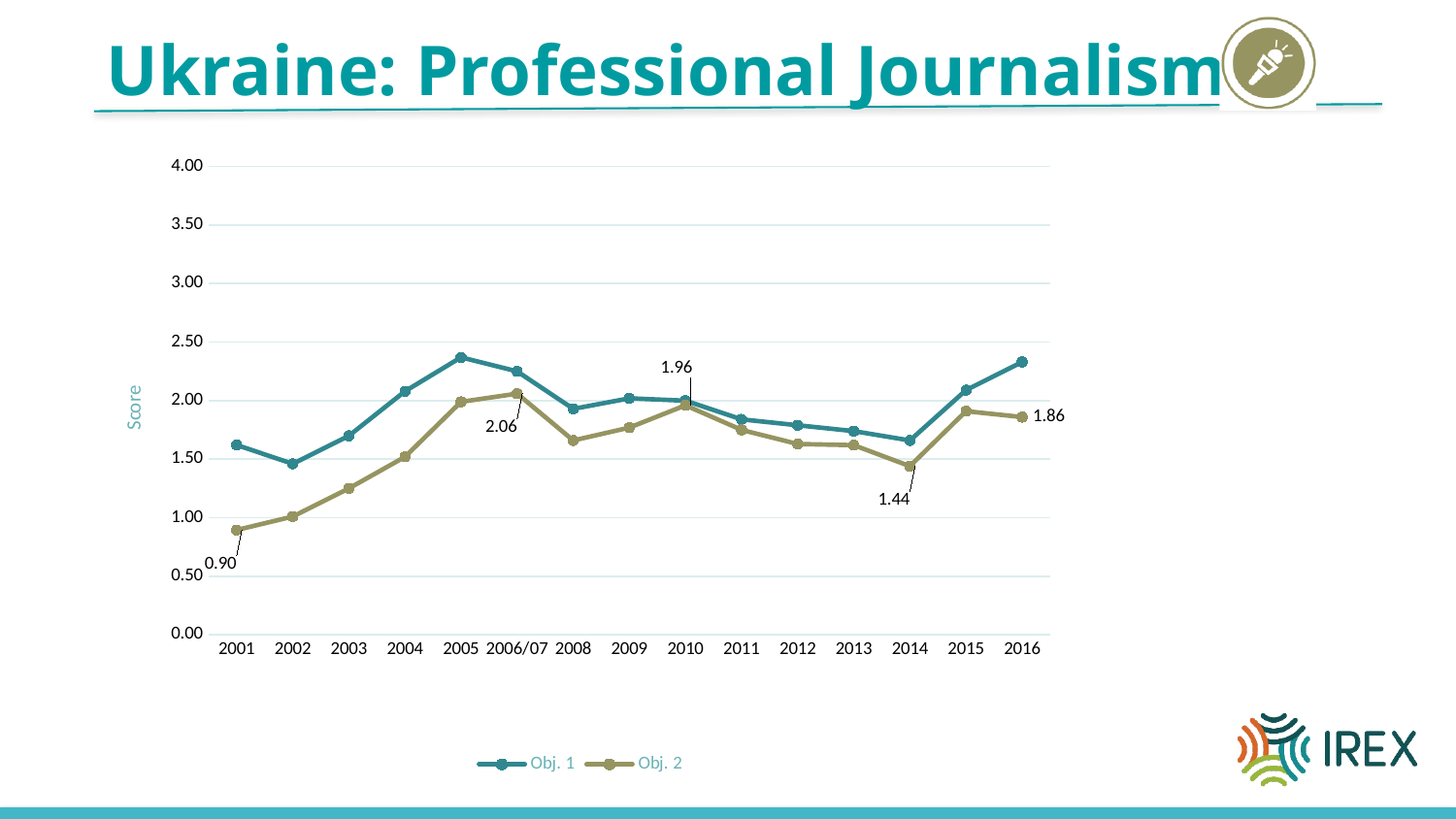
In which year does Obj. 2 have its lowest score? 2001 What is the Obj. 2 score in 2014? 1.44 In which year does Obj. 1 reach its highest score? 2005 Is the Obj. 2 score in 2003 greater or less than 1.50? less What is the Obj. 2 score in 2001? 0.90 What is the Obj. 2 score in 2006/07? 2.06 Is the Obj. 1 score in 2005 greater or less than 2.00? greater By how much did the Obj. 2 score increase from 2014 to 2016? 0.42 Which series has the higher score in 2005, Obj. 1 or Obj. 2? Obj. 1 What is the Obj. 2 score in 2016? 1.86 What kind of chart is shown on the slide? line chart How many series does the legend list? 2